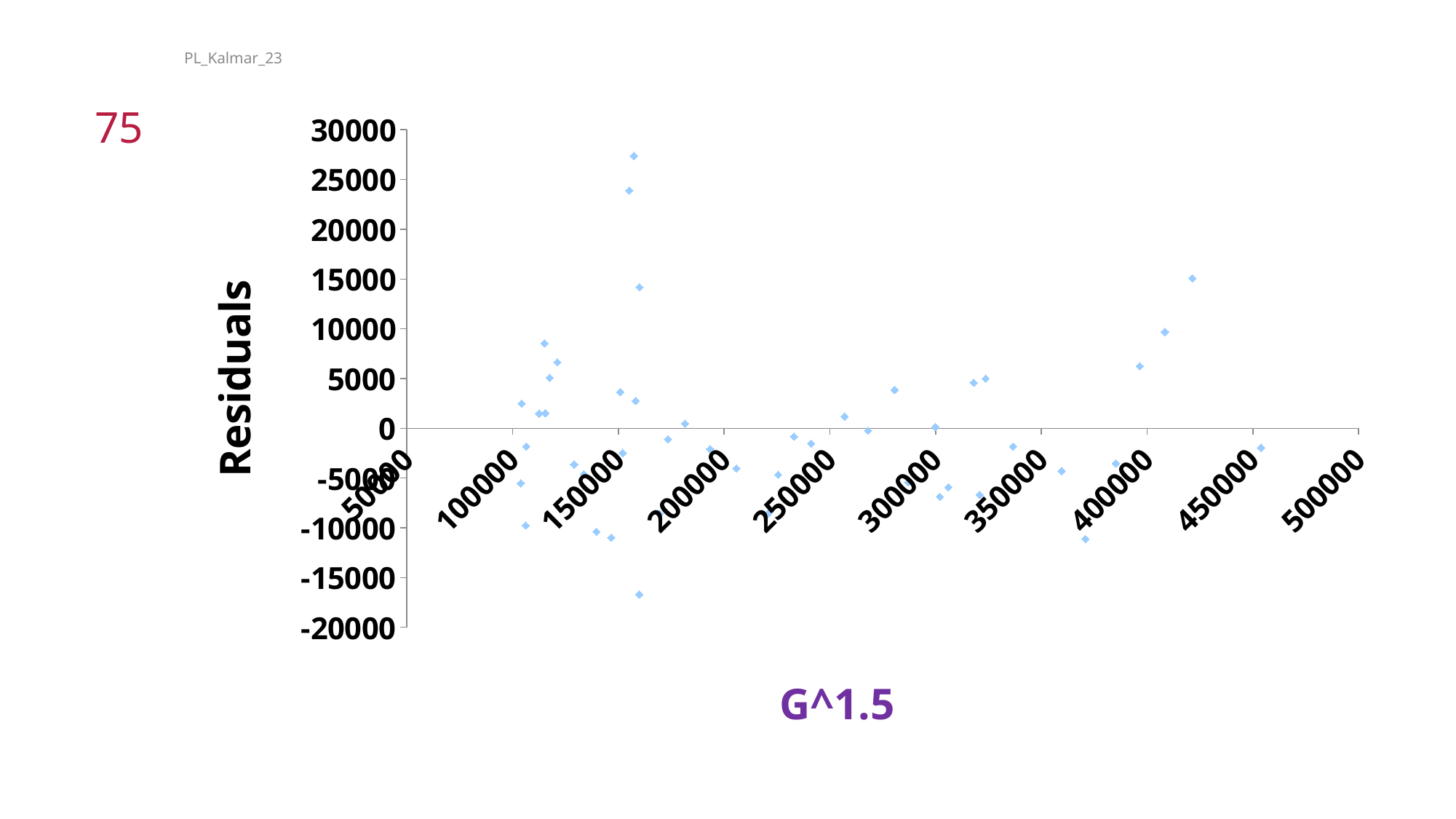
Is the highest residual value plotted on the chart greater or less than 25000? greater Is the highest residual among points with G^1.5 above 400000 greater or less than 20000? less Is the highest residual among points with G^1.5 between 200000 and 300000 greater or less than 5000? less What is the title of the horizontal axis of the chart? G^1.5 What is the title of the vertical axis of the chart? Residuals What kind of chart is shown on the slide? scatter chart